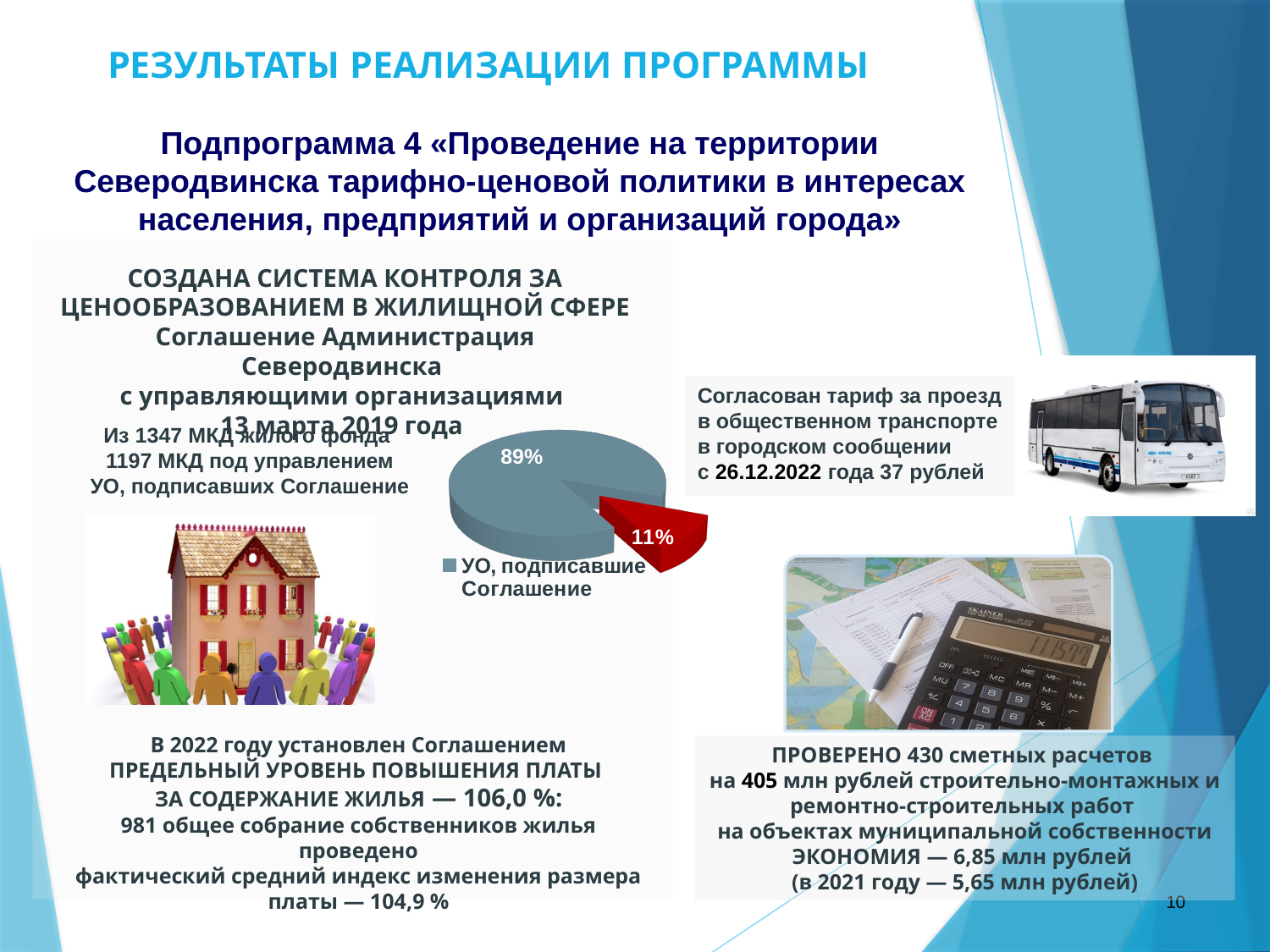
What is the total of the two percentages shown on the pie chart? 100% What share of the pie is labelled for the slice "УО, подписавшие Соглашение"? 89% What kind of chart is shown on the slide? pie chart What is the legend entry shown below the pie chart? УО, подписавшие Соглашение Which slice of the pie chart is the largest? УО, подписавшие Соглашение What percentage is shown on the smaller, red slice of the pie chart? 11% What is the difference in percentage points between the two slices of the pie chart? 78 Is the slice for "УО, подписавшие Соглашение" larger or smaller than the red slice? larger How many entries does the legend of the pie chart list? 1 What colour is the slice labelled 11% in the pie chart? red How many slices does the pie chart have? 2